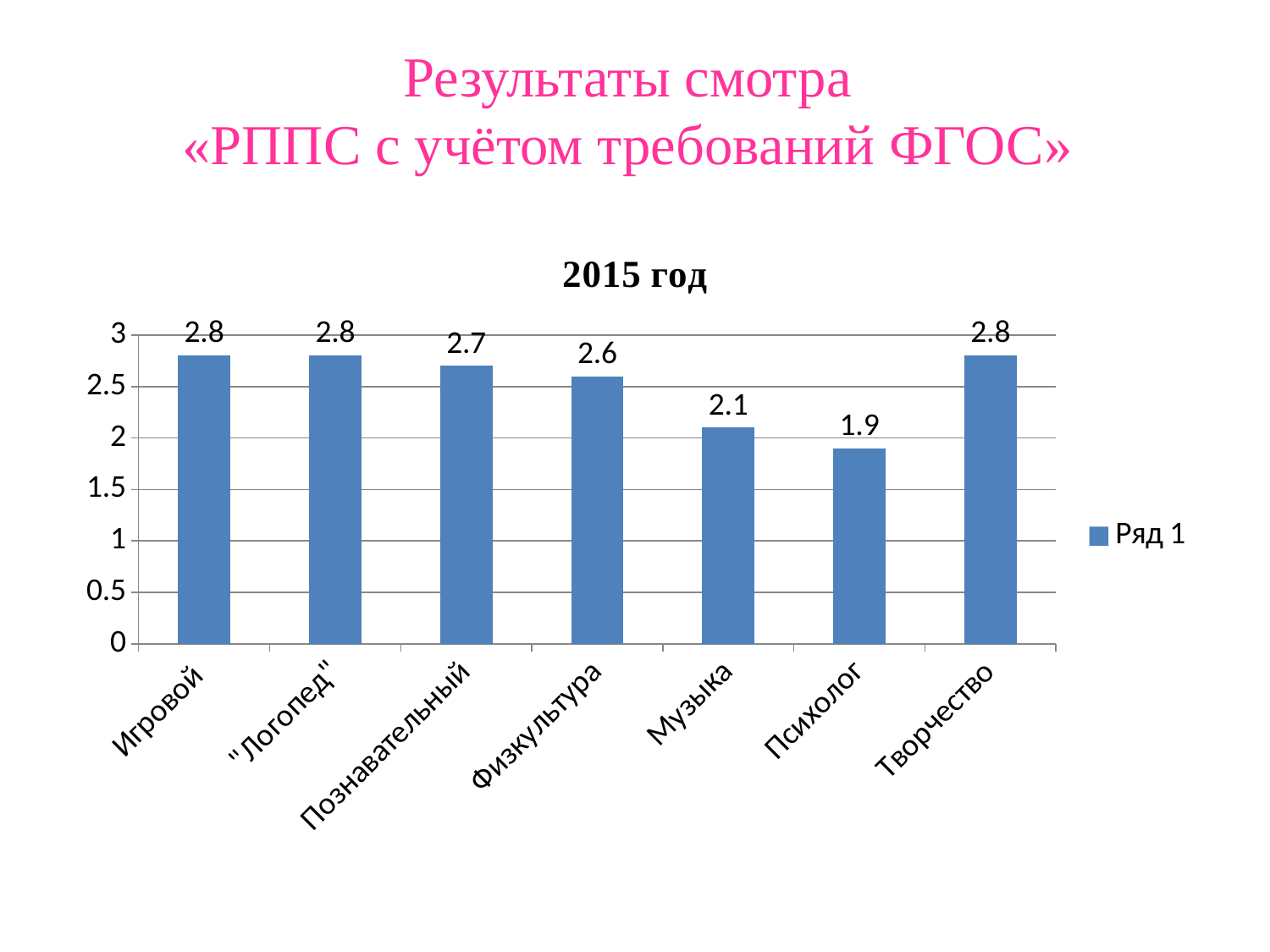
Is the value for Психолог greater or less than 2? less What is the value for Музыка? 2.1 What is the value for Психолог? 1.9 Which is larger, the value for Физкультура or the value for Музыка? Физкультура What is the difference between the values for Познавательный and Музыка? 0.6 What is the value for Познавательный? 2.7 What is the difference between the values for Игровой and Психолог? 0.9 What kind of chart is shown? bar chart Which category has the lowest value? Психолог What is the title of the chart? 2015 год How many categories are shown on the x axis? 7 What is the value for Физкультура? 2.6